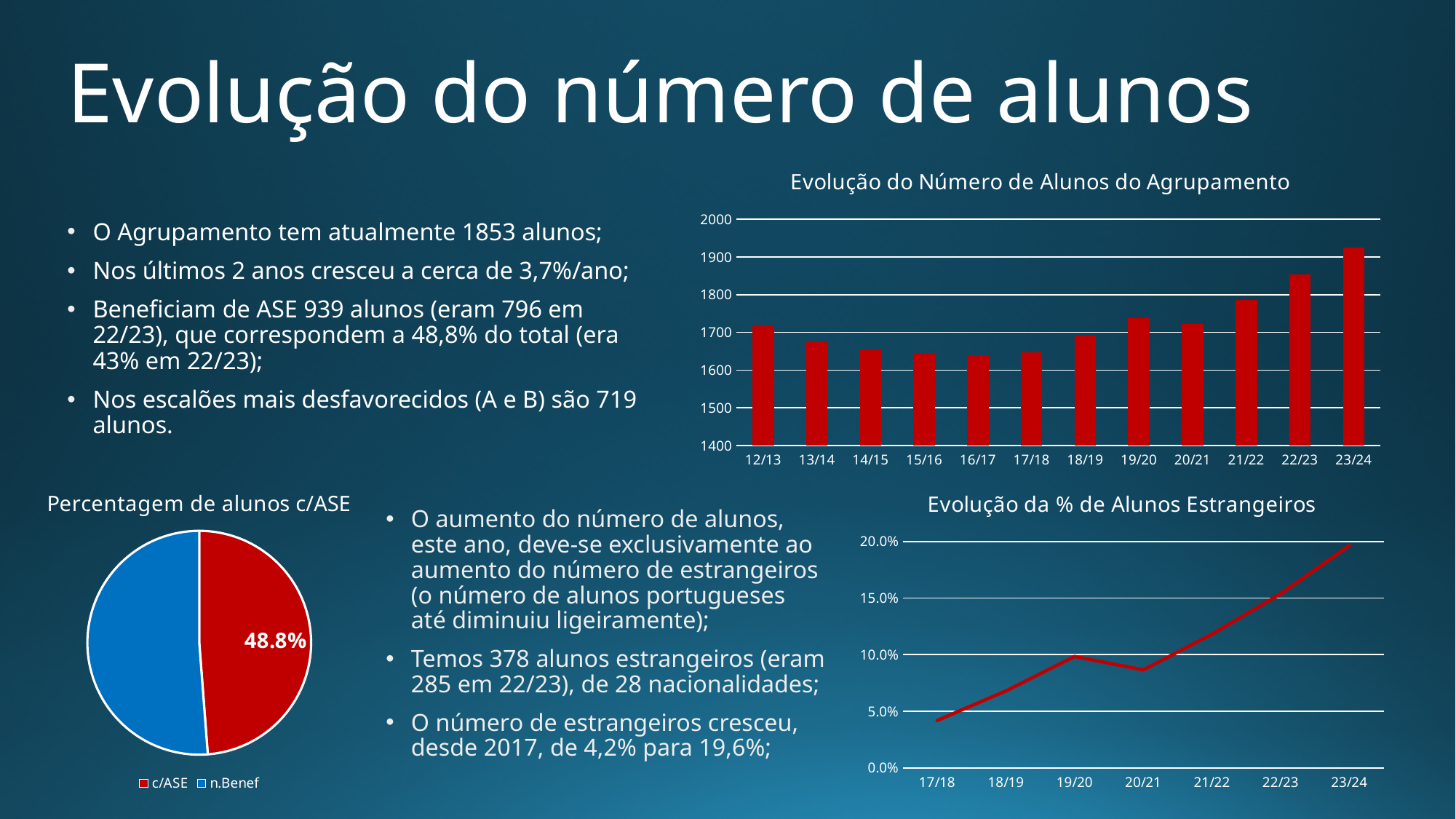
What kind of chart is 'Evolução do Número de Alunos do Agrupamento'? bar chart In the chart 'Evolução da % de Alunos Estrangeiros', do the values generally rise or fall from 17/18 to 23/24? rise In the chart 'Evolução do Número de Alunos do Agrupamento', which school year has the highest number of students? 23/24 In the chart 'Evolução da % de Alunos Estrangeiros', is the value for 17/18 greater or less than 5.0%? less In the chart 'Evolução do Número de Alunos do Agrupamento', how many school years are shown on the x axis? 12 In the pie chart 'Percentagem de alunos c/ASE', what share is shown for c/ASE? 48.8% In the chart 'Evolução do Número de Alunos do Agrupamento', is the value for 16/17 greater or less than 1700? less In the chart 'Evolução do Número de Alunos do Agrupamento', is the value for 22/23 greater or less than 1800? greater What kind of chart is 'Evolução da % de Alunos Estrangeiros'? line chart How many entries does the legend of the pie chart 'Percentagem de alunos c/ASE' list? 2 In the chart 'Evolução do Número de Alunos do Agrupamento', which is larger, the value for 21/22 or the value for 20/21? 21/22 In the chart 'Evolução da % de Alunos Estrangeiros', how many school years are shown on the x axis? 7